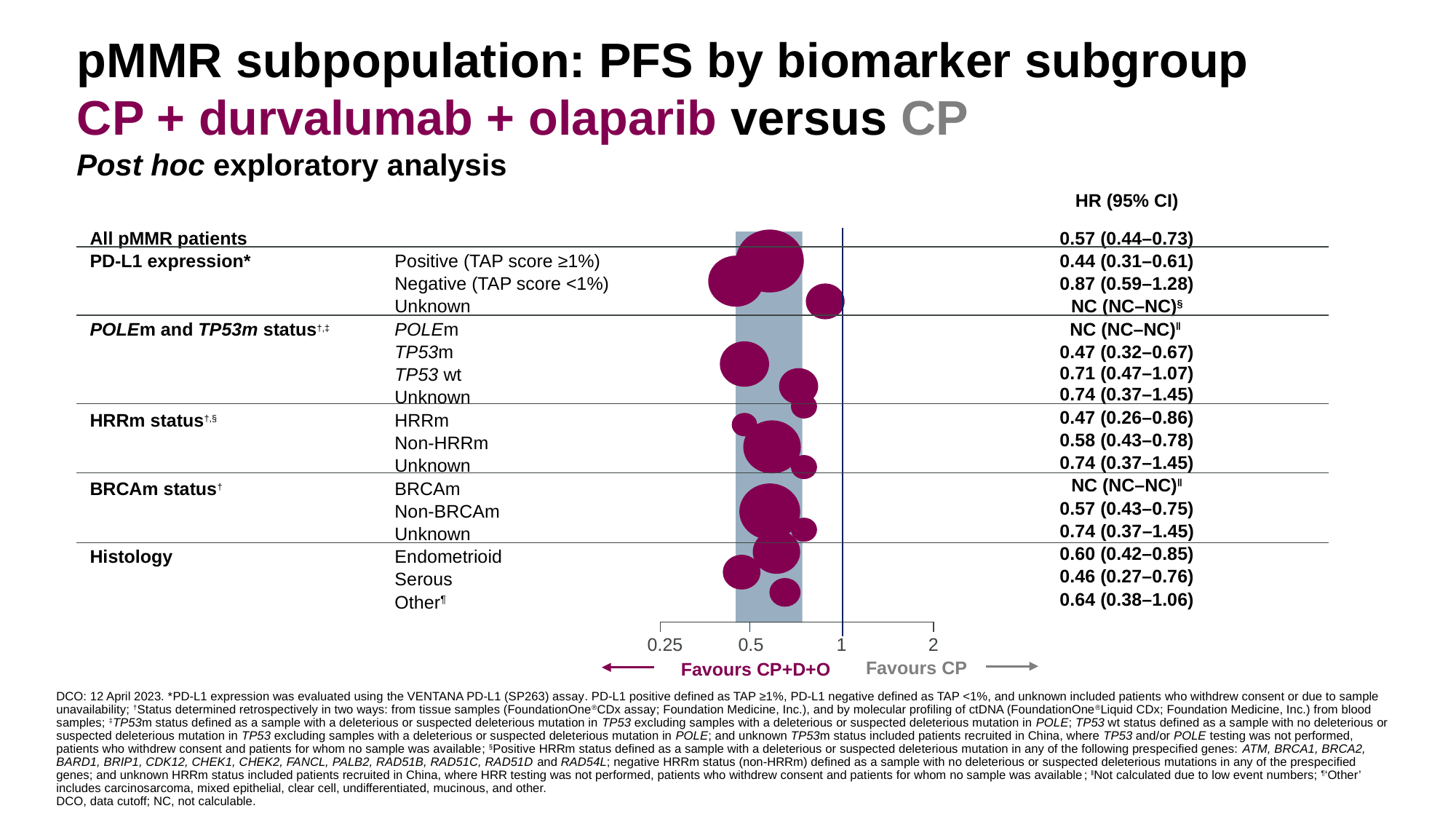
Which subgroup has the lowest hazard ratio point estimate? PD-L1 positive (TAP score ≥1%) What is the hazard ratio (95% CI) for all pMMR patients? 0.57 (0.44–0.73) Among subgroups with a calculated HR, which has the highest hazard ratio point estimate? PD-L1 negative (TAP score <1%) What is the HR (95% CI) for the PD-L1 positive (TAP score ≥1%) subgroup? 0.44 (0.31–0.61) What is the difference between the HR point estimates for the PD-L1 negative and PD-L1 positive subgroups? 0.43 Which has the larger HR point estimate: HRRm or Non-HRRm? Non-HRRm What kind of chart is shown on the slide? Forest plot What is the HR (95% CI) for the serous histology subgroup? 0.46 (0.27–0.76) What does the left-pointing arrow below the x axis indicate? Favours CP+D+O How many subgroups have an HR reported as NC (not calculable)? 3 Is the HR point estimate for the PD-L1 negative subgroup greater or less than 1? less What is the HR (95% CI) for the TP53 wt subgroup? 0.71 (0.47–1.07)